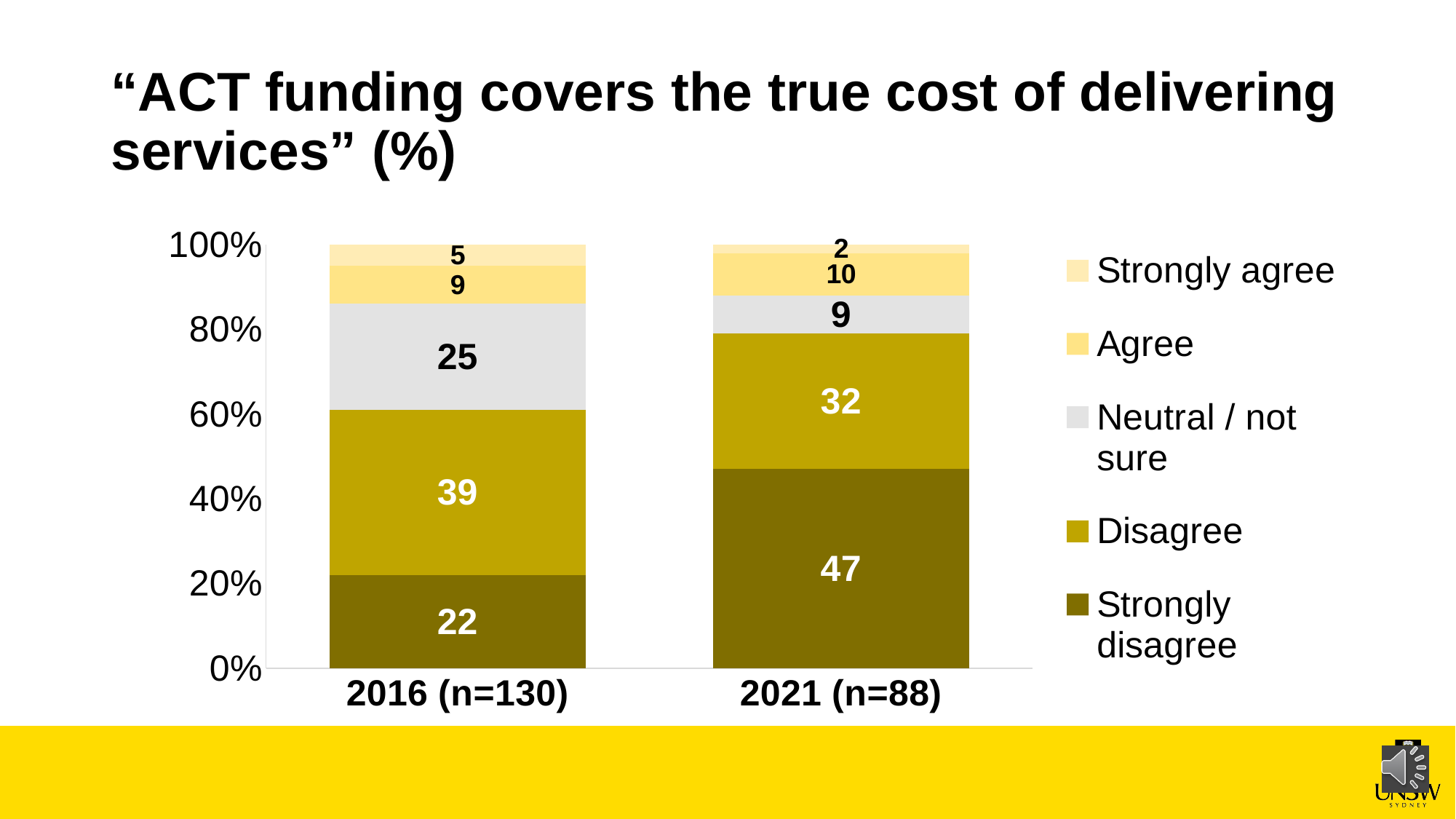
Which response category has the smallest value in 2016 (n=130)? Strongly agree How many series does the legend list? 5 Which response category has the largest value in 2021 (n=88)? Strongly disagree What is the value for Disagree in 2021 (n=88)? 32 What is the value for Neutral / not sure in 2016 (n=130)? 25 What is the value for Strongly agree in 2021 (n=88)? 2 What is the difference between the Strongly disagree values for 2021 (n=88) and 2016 (n=130)? 25 Which is larger: Disagree in 2016 (n=130) or Disagree in 2021 (n=88)? Disagree in 2016 (n=130) Which legend entry is shown in the darkest colour? Strongly disagree What is the value for Strongly disagree in 2016 (n=130)? 22 What kind of chart is shown on the slide? Stacked bar chart What is the value for Agree in 2021 (n=88)? 10